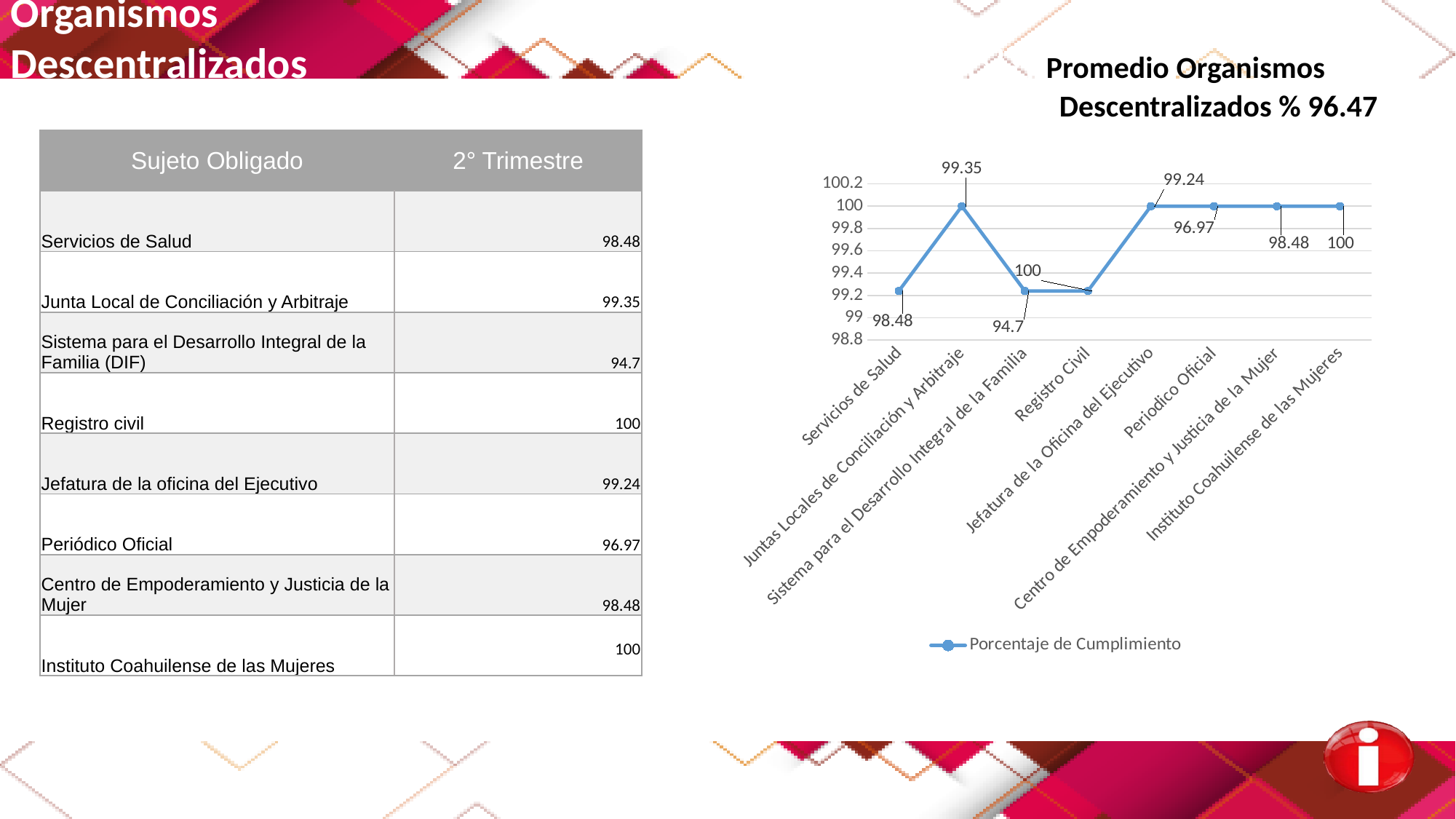
What is the data label value for Juntas Locales de Conciliación y Arbitraje in the chart? 99.35 What is the data label value for Instituto Coahuilense de las Mujeres in the chart? 100 What is the difference between the data label values for Juntas Locales de Conciliación y Arbitraje and Periodico Oficial? 2.38 Which has the larger data label value, Jefatura de la Oficina del Ejecutivo or Periodico Oficial? Jefatura de la Oficina del Ejecutivo How many series does the chart legend list? 1 What is the name of the series shown in the chart legend? Porcentaje de Cumplimiento What is the data label value for Centro de Empoderamiento y Justicia de la Mujer in the chart? 98.48 What kind of chart is shown on the slide? line chart What is the data label value for Periodico Oficial in the chart? 96.97 What is the data label value for Servicios de Salud in the chart? 98.48 What is the data label value for Jefatura de la Oficina del Ejecutivo in the chart? 99.24 How many categories are plotted along the x axis of the chart? 8